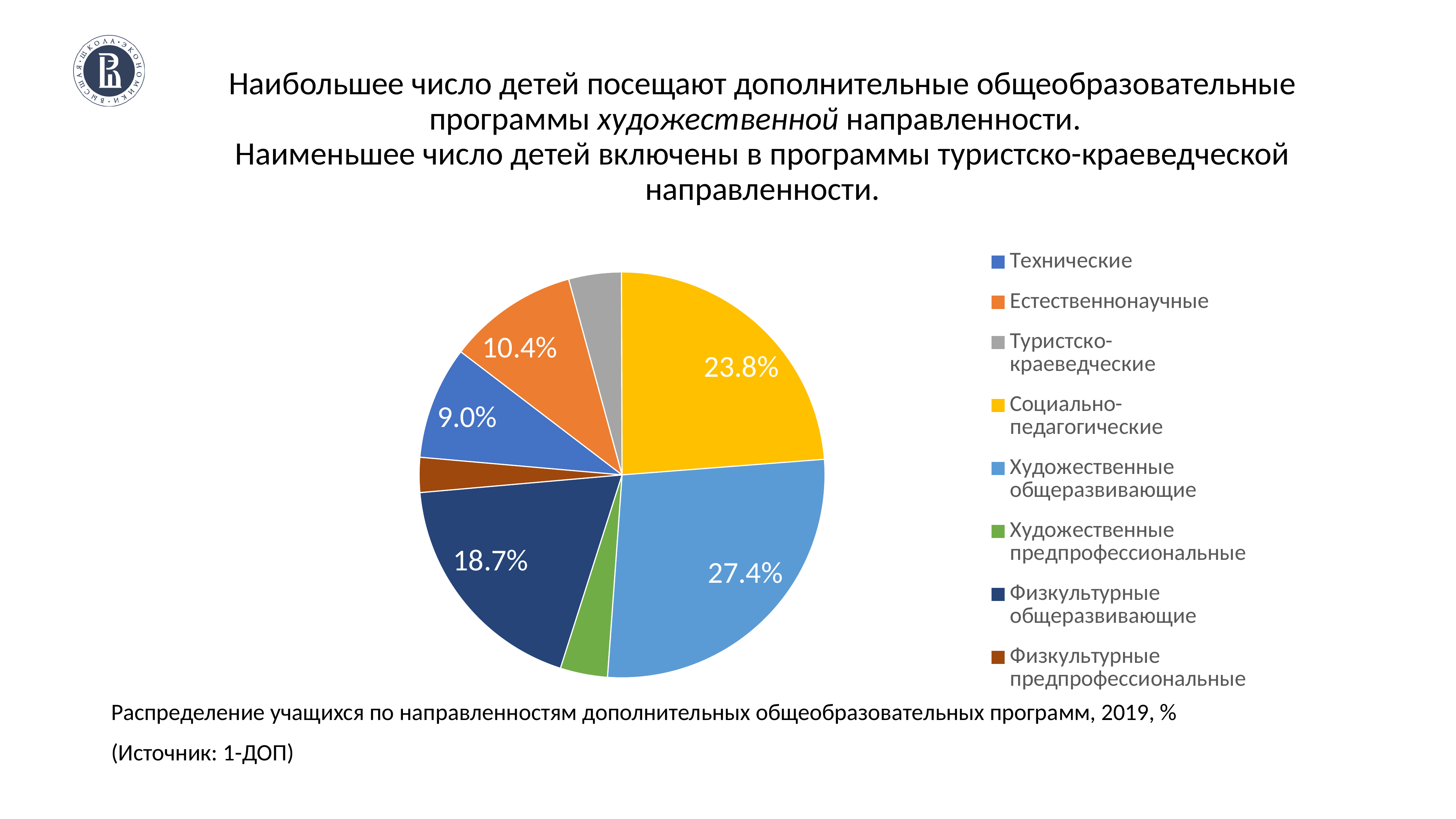
What share of the pie does Художественные общеразвивающие account for? 27.4% What is the value for Естественнонаучные? 10.4% How many categories does the legend list? 8 What is the difference between the shares of Социально-педагогические and Физкультурные общеразвивающие? 5.1 percentage points Which category has the largest slice of the pie? Художественные общеразвивающие What is the value for Технические? 9.0% What kind of chart is shown on the slide? Pie chart What is the value shown for Социально-педагогические? 23.8% Which is larger, the share for Технические or for Естественнонаучные? Естественнонаучные What colour is the slice for Социально-педагогические? Yellow What is the difference between the shares of Художественные общеразвивающие and Социально-педагогические? 3.6 percentage points What percentage is shown for Физкультурные общеразвивающие? 18.7%